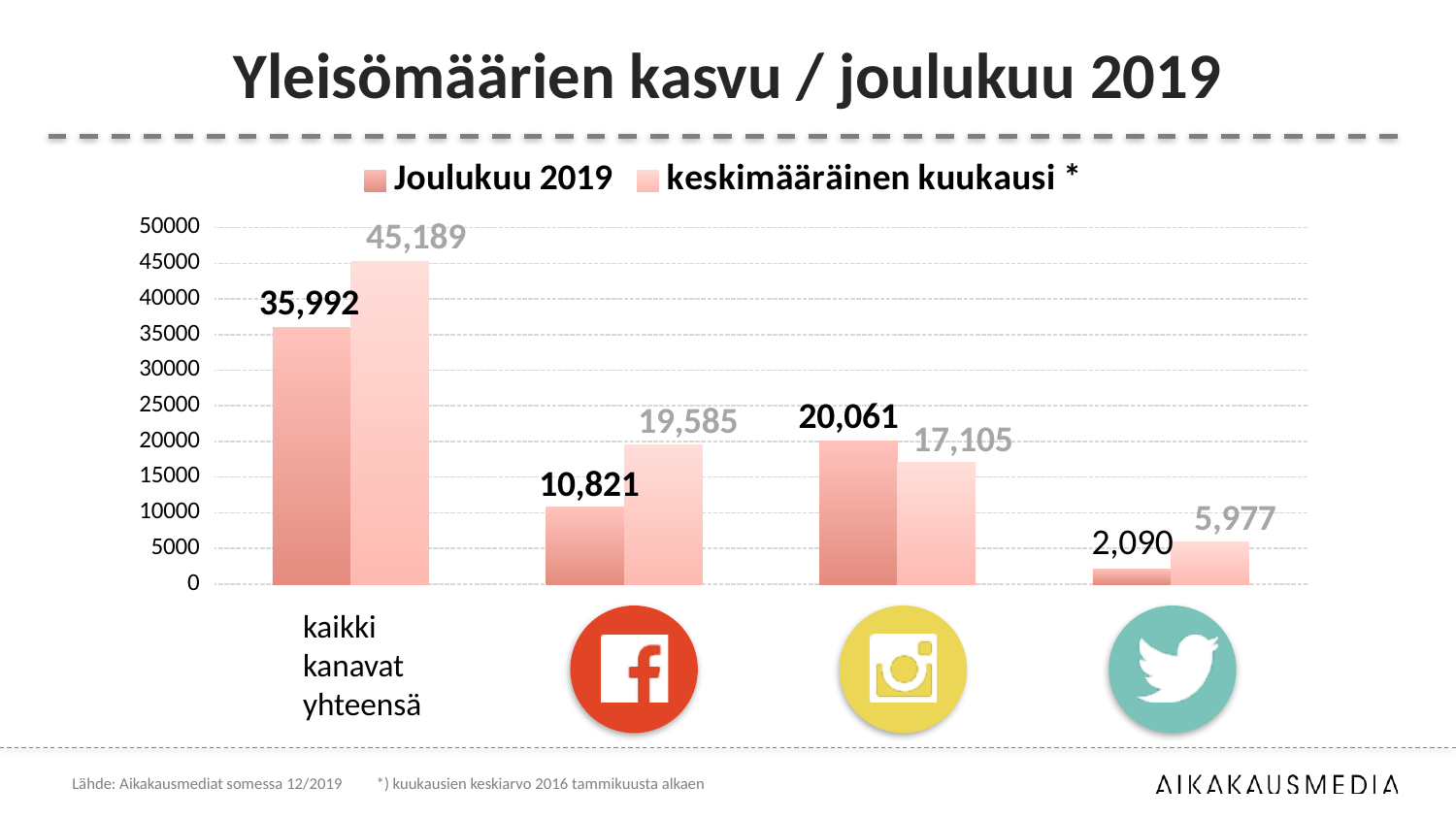
What is the Joulukuu 2019 value for the Twitter category? 2,090 How many categories are shown on the x axis? 4 What is the keskimääräinen kuukausi value for the Instagram category? 17,105 For the Instagram category, which is larger: the Joulukuu 2019 value or the keskimääräinen kuukausi value? Joulukuu 2019 Which category has the lowest Joulukuu 2019 value? Twitter How many series does the legend list? 2 What is the title of the slide? Yleisömäärien kasvu / joulukuu 2019 What is the difference between the keskimääräinen kuukausi and Joulukuu 2019 values for the Facebook category? 8,764 What is the keskimääräinen kuukausi value for kaikki kanavat yhteensä? 45,189 What kind of chart is shown on the slide? Bar chart What is the Joulukuu 2019 value for the Facebook category? 10,821 What is the value for Joulukuu 2019 for kaikki kanavat yhteensä? 35,992